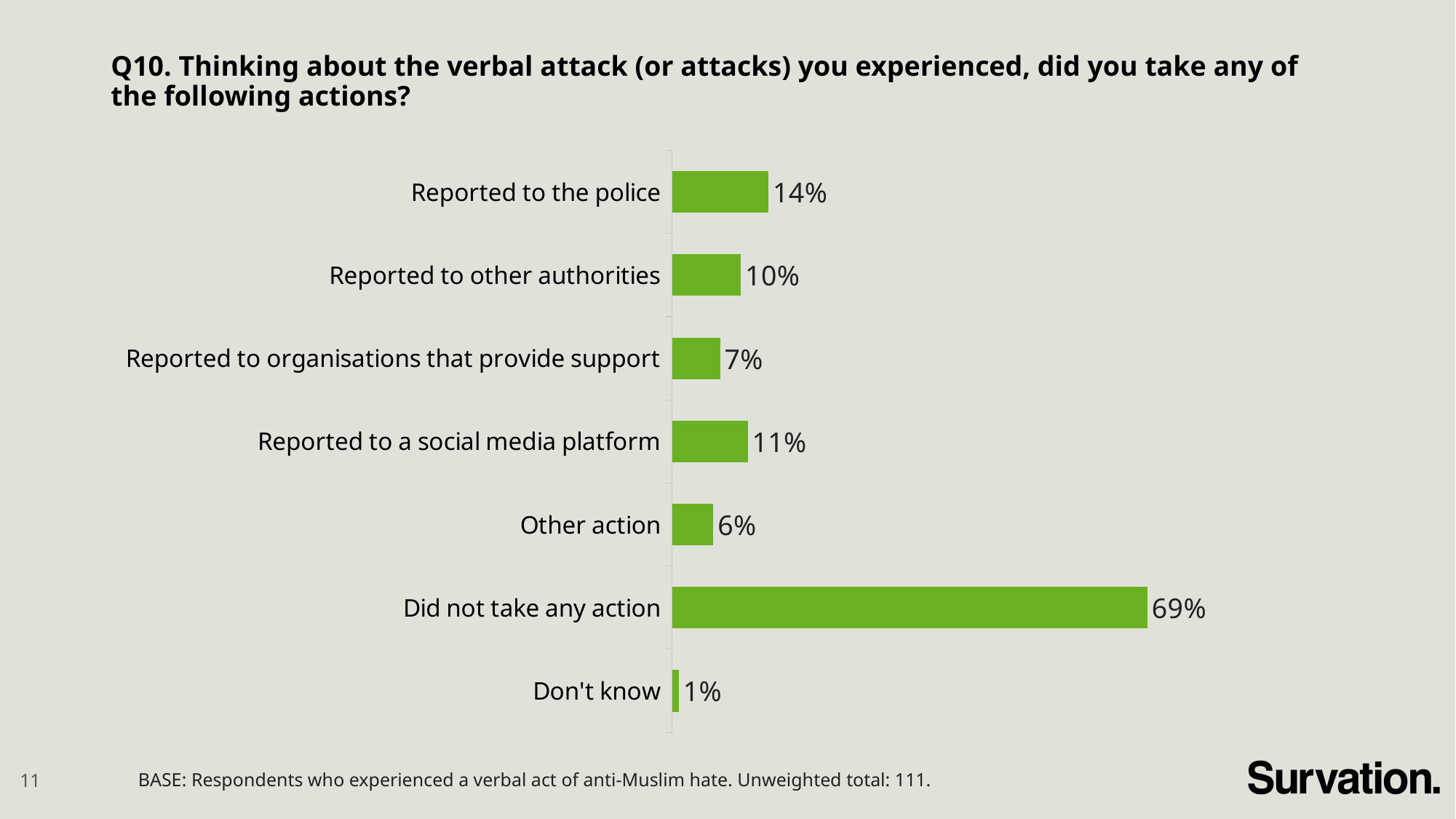
What is the difference between "Reported to other authorities" and "Other action"? 4 percentage points What percentage reported to a social media platform? 11% What kind of chart is shown on the slide? Bar chart What is the difference between "Did not take any action" and "Reported to the police"? 55 percentage points How many categories are shown in the chart? 7 What is the unweighted total of respondents stated in the base note? 111 Which category has the lowest value? Don't know Which is larger: "Reported to a social media platform" or "Reported to other authorities"? Reported to a social media platform Which category has the highest value? Did not take any action What percentage of respondents reported the verbal attack to the police? 14% What is the value for "Did not take any action"? 69% What is the value for "Reported to organisations that provide support"? 7%